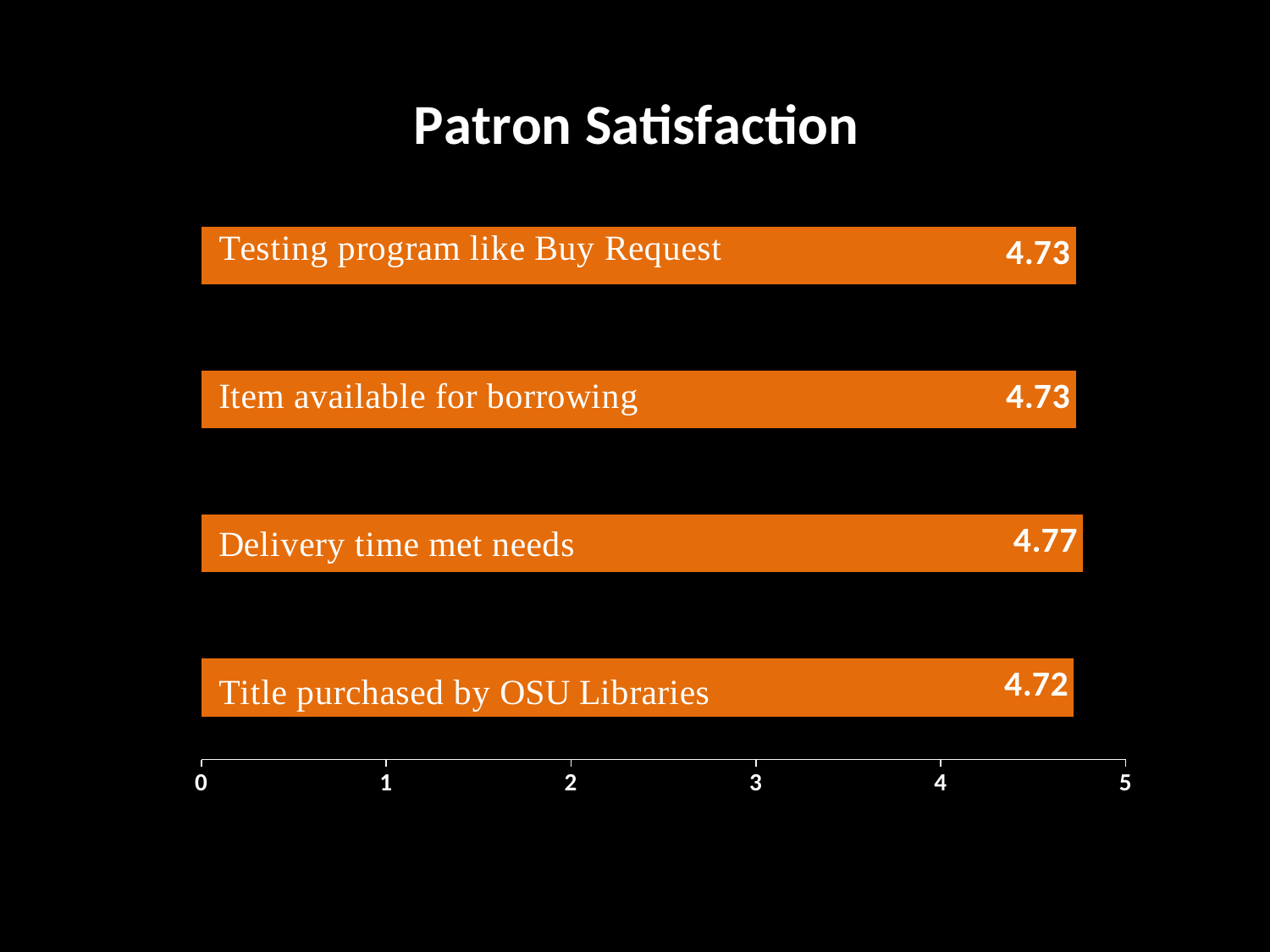
What kind of chart is shown on the slide? Bar chart Is the value for "Item available for borrowing" greater or less than 4? greater Which is larger, the value for "Delivery time met needs" or the value for "Title purchased by OSU Libraries"? Delivery time met needs What is the value for "Title purchased by OSU Libraries"? 4.72 What is the value for "Delivery time met needs"? 4.77 Which category has the highest value? Delivery time met needs What is the difference between the values for "Delivery time met needs" and "Title purchased by OSU Libraries"? 0.05 Which category has the lowest value? Title purchased by OSU Libraries What is the value for "Item available for borrowing"? 4.73 How many categories are shown in the chart? 4 What is the value for "Testing program like Buy Request"? 4.73 What is the difference between the values for "Delivery time met needs" and "Item available for borrowing"? 0.04